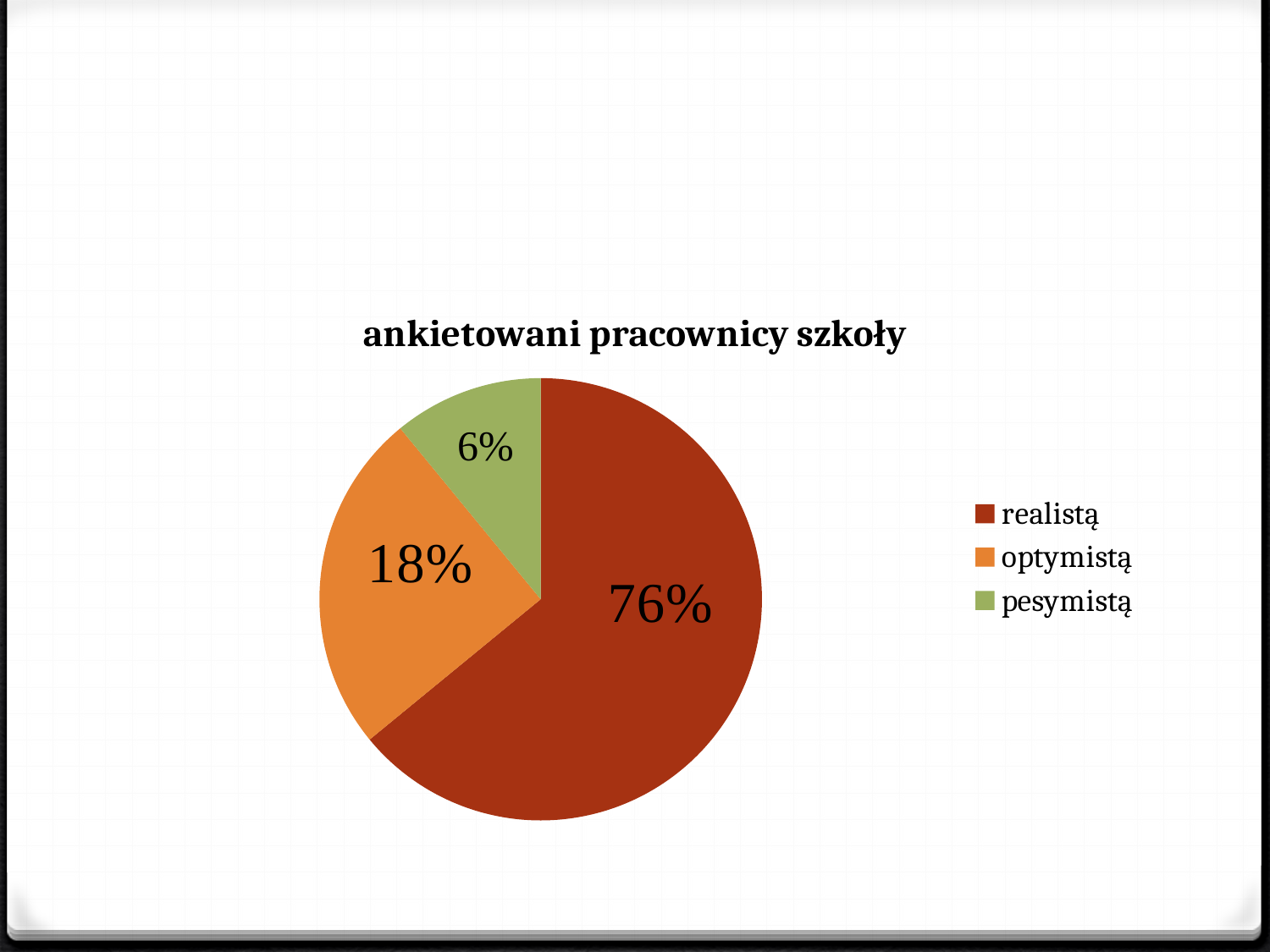
Which slice is larger, optymistą or pesymistą? optymistą What is the difference in percentage points between the realistą and optymistą slices? 58 What share of the pie is labelled realistą? 76% How many slices does the pie chart have? 3 What colour is the slice for pesymistą? green What is the title of the chart? ankietowani pracownicy szkoły Which category has the smallest slice of the pie? pesymistą What share of the pie is labelled pesymistą? 6% Which category has the largest slice of the pie? realistą What type of chart is shown on the slide? pie chart How many entries does the legend list? 3 What share of the pie is labelled optymistą? 18%